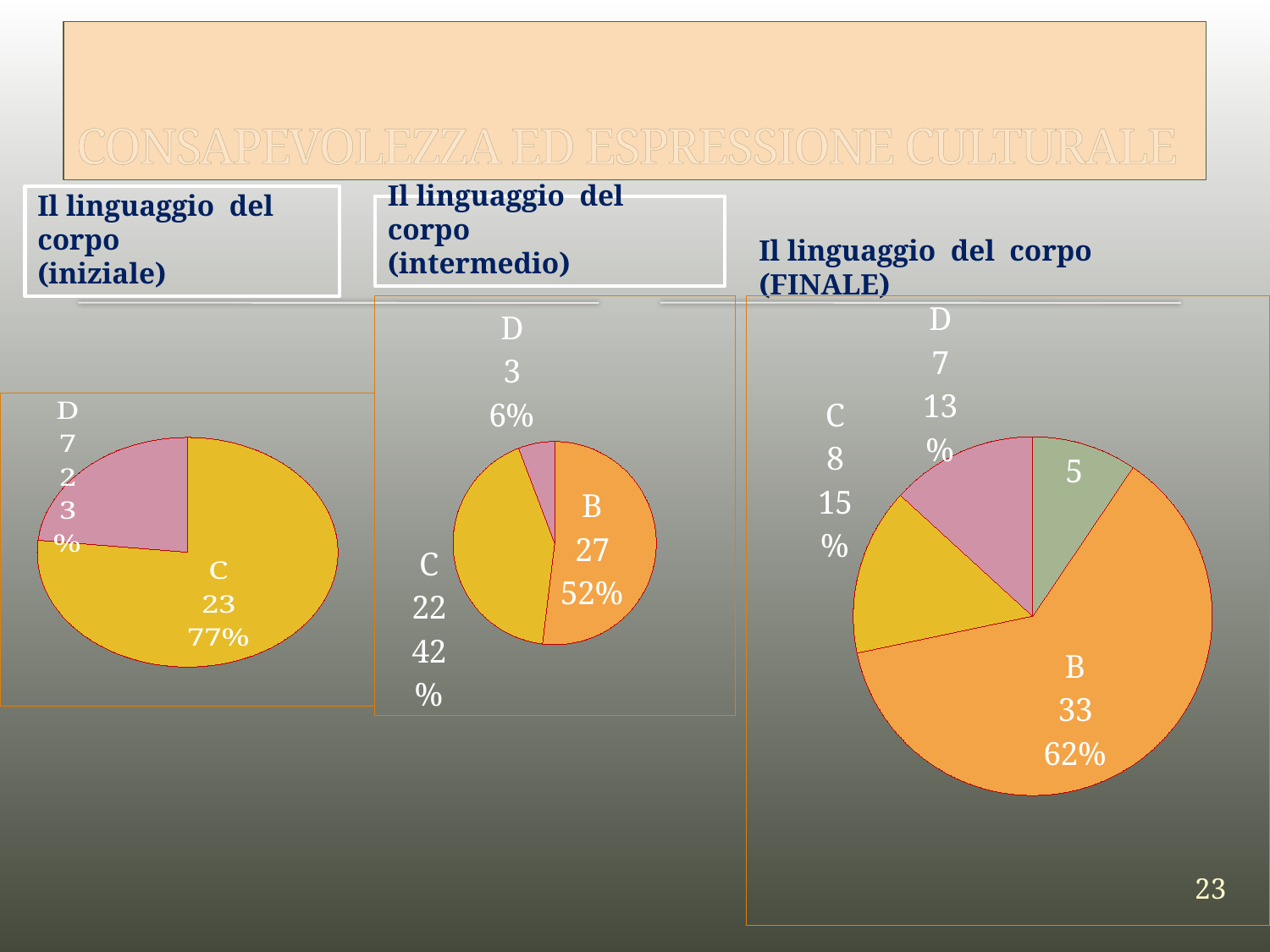
In the 'Il linguaggio del corpo (iniziale)' chart, what share of the pie does D have? 23% In the 'Il linguaggio del corpo (intermedio)' chart, what is the difference between the values for B and C? 5 What kind of chart is used for 'Il linguaggio del corpo (iniziale)'? pie chart In the 'Il linguaggio del corpo (iniziale)' chart, what value is shown for C? 23 How many slices does the 'Il linguaggio del corpo (iniziale)' pie chart have? 2 In the 'Il linguaggio del corpo (FINALE)' chart, what value is shown for B? 33 In the 'Il linguaggio del corpo (intermedio)' chart, what share of the pie does C have? 42% In the 'Il linguaggio del corpo (FINALE)' chart, which category has the largest slice? B How many slices does the 'Il linguaggio del corpo (FINALE)' pie chart have? 4 In the 'Il linguaggio del corpo (intermedio)' chart, which category has the smallest slice? D In the 'Il linguaggio del corpo (intermedio)' chart, what value is shown for B? 27 In the 'Il linguaggio del corpo (FINALE)' chart, which is larger, the value for C or the value for D? C